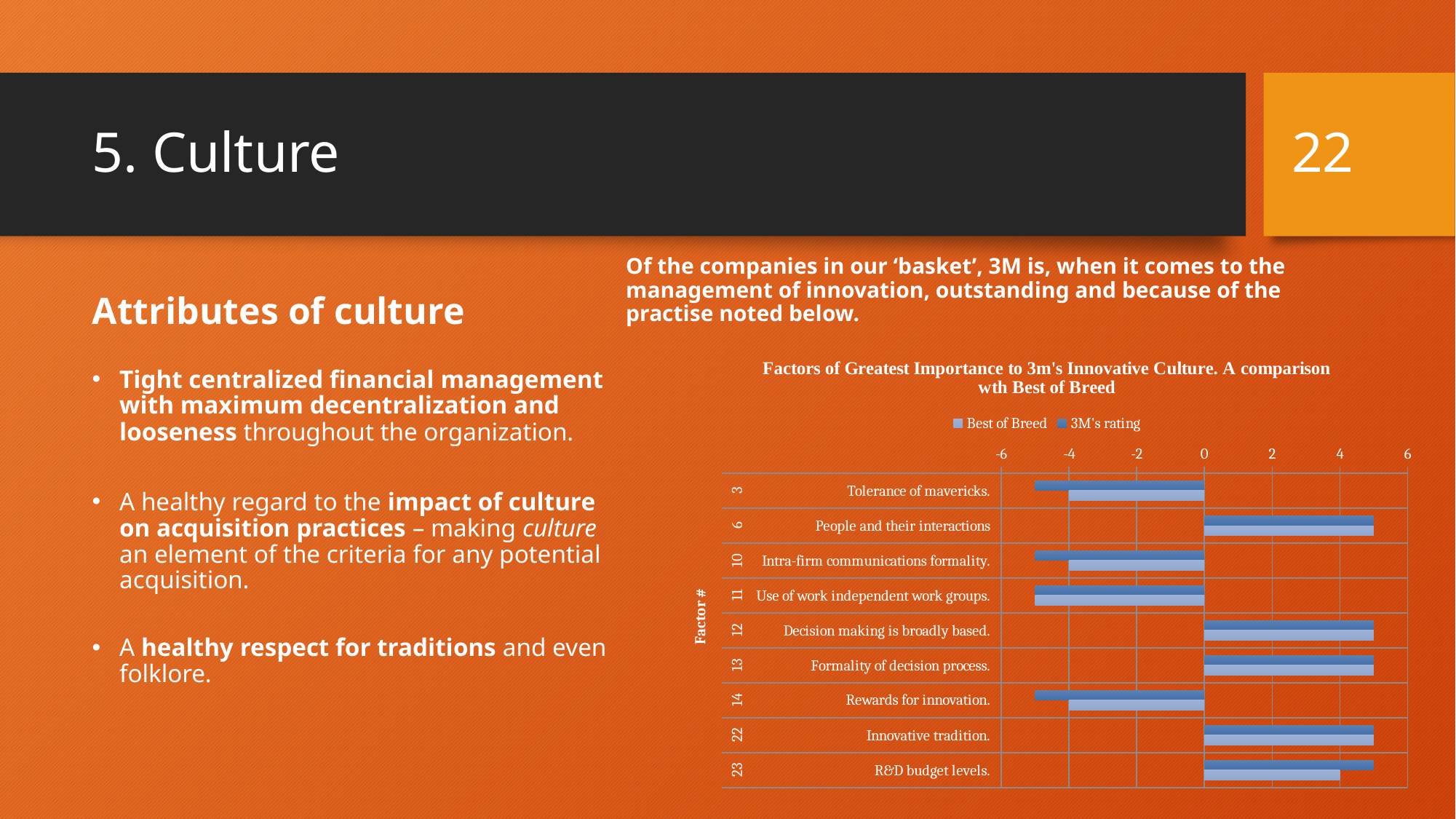
How many factors (categories) are plotted in the chart? 9 Are the values for 'Tolerance of mavericks.' greater or less than 0? less Are the values for 'Rewards for innovation.' greater or less than -2? less How many series does the chart's legend list? 2 Are the values for 'People and their interactions' greater or less than 2? greater What are the two series named in the chart's legend? Best of Breed and 3M's rating What kind of chart is shown on the slide? bar chart Which factor number is listed for 'R&D budget levels.' on the vertical axis? 23 What is the title of the chart's vertical axis? Factor # Which has the larger value: 'Decision making is broadly based.' or 'Intra-firm communications formality.'? Decision making is broadly based.